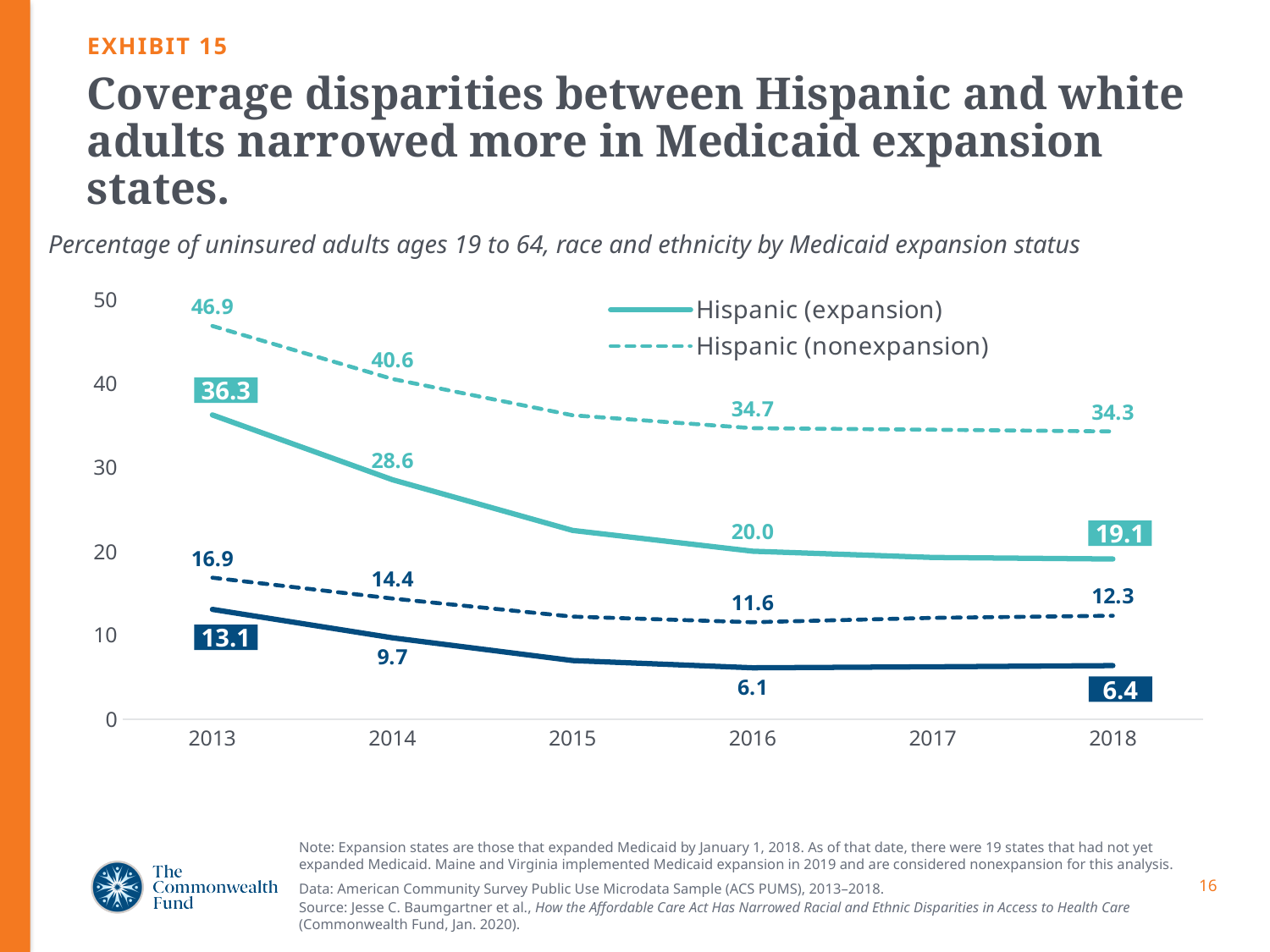
Does the Hispanic (expansion) line rise or fall from 2013 to 2018? fall What is the value for Hispanic (expansion) in 2016? 20.0 Is the value for Hispanic (nonexpansion) in 2017 greater or less than 40? less By how much did the Hispanic (nonexpansion) value fall from 2013 to 2018? 12.6 How many series does the legend list? 2 What is the value for Hispanic (nonexpansion) in 2018? 34.3 In 2014, which is larger: Hispanic (expansion) or Hispanic (nonexpansion)? Hispanic (nonexpansion) In 2018, what is the difference between the Hispanic (nonexpansion) and Hispanic (expansion) values? 15.2 How many years are shown on the x axis? 6 Is the value for Hispanic (expansion) in 2015 greater or less than 20? greater What is the value for Hispanic (expansion) in 2013? 36.3 What kind of chart is shown on the slide? line chart